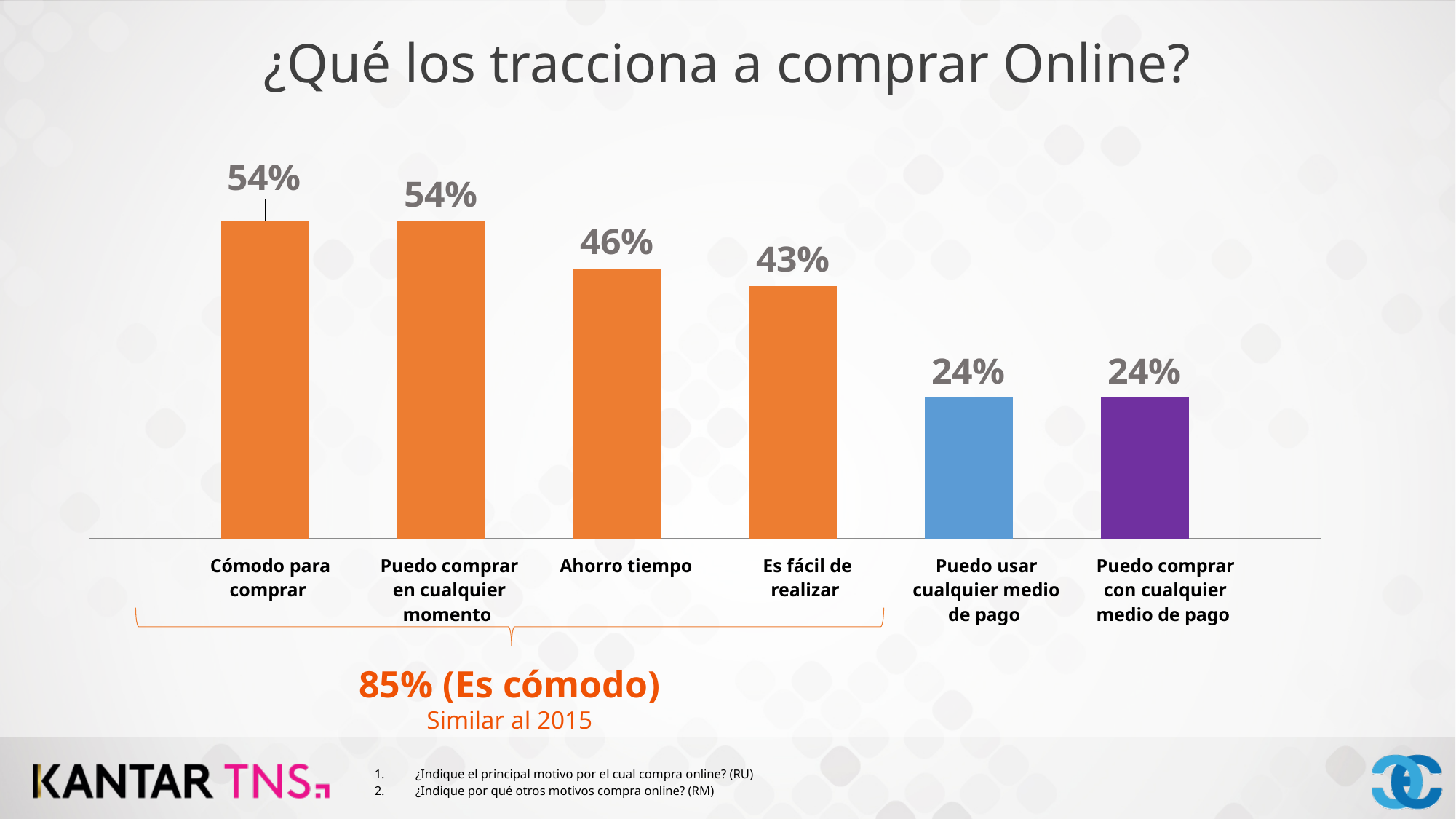
What is the value for "Cómodo para comprar"? 54% Do the values rise or fall from left to right across the categories? Fall What is the difference between "Ahorro tiempo" and "Es fácil de realizar"? 3% What is the difference between "Cómodo para comprar" and "Puedo usar cualquier medio de pago"? 30% How many categories are shown in the chart? 6 What is the title of the slide? ¿Qué los tracciona a comprar Online? What kind of chart is shown on the slide? Bar chart What is the value for "Ahorro tiempo"? 46% Which category has the lowest value among the orange bars? Es fácil de realizar What is the value for "Es fácil de realizar"? 43% What is the value for "Puedo usar cualquier medio de pago"? 24% Which is larger, "Ahorro tiempo" or "Puedo comprar con cualquier medio de pago"? Ahorro tiempo